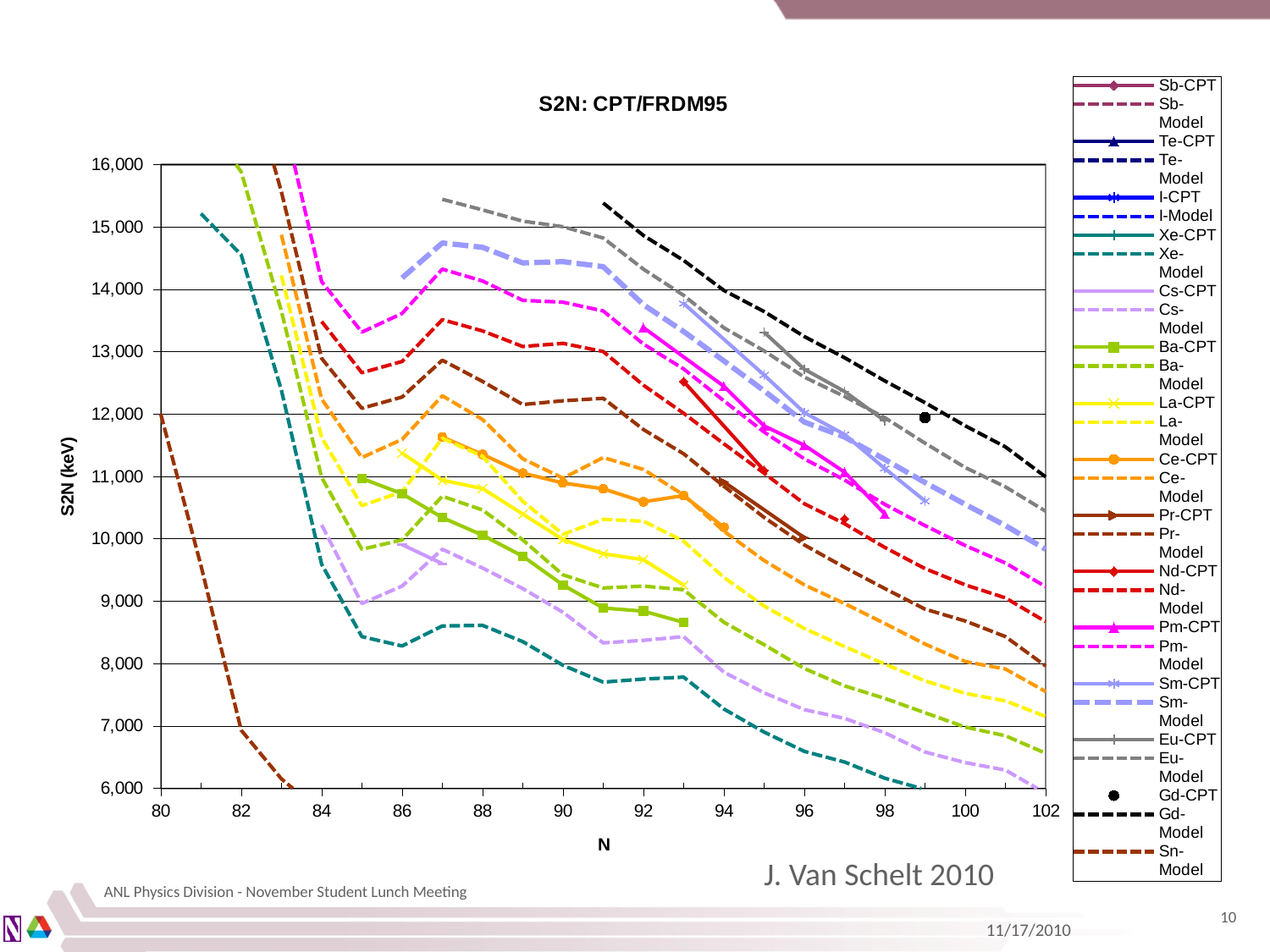
Is the value for Eu-CPT at N = 95 greater or less than 13,000? greater How many series does the legend list? 29 What is the label of the vertical axis? S2N (keV) What is the highest value shown on the vertical axis? 16,000 Is the value for Ba-CPT at N = 93 greater or less than 9,000? less At N = 93, which series has the larger value, Pm-CPT or Ba-CPT? Pm-CPT What is the title of the chart? S2N: CPT/FRDM95 Is the value for Pm-CPT at N = 92 greater or less than 13,000? greater Do the S2N values generally rise or fall as N increases along the x axis? fall What kind of chart is shown on the slide? line chart